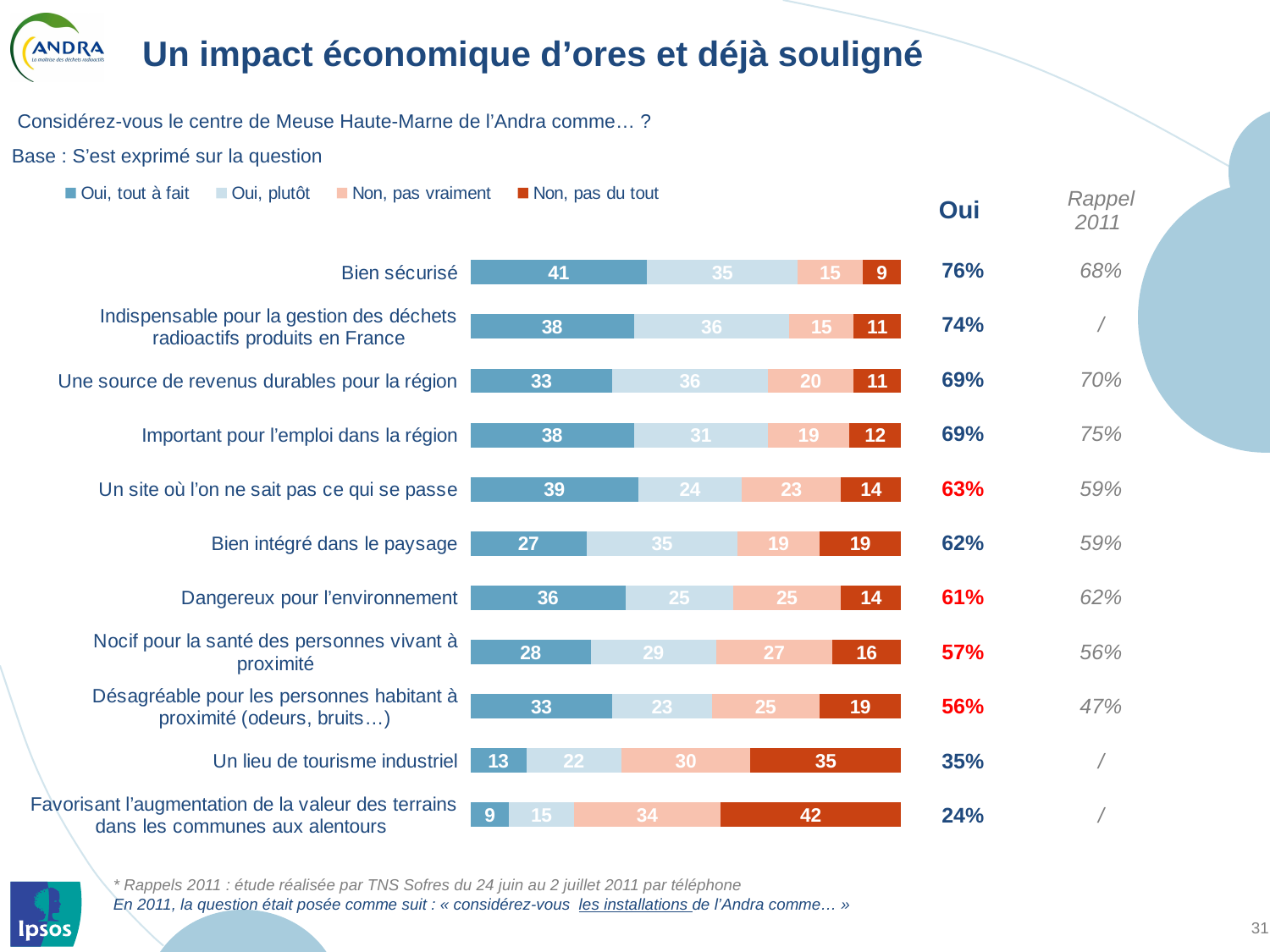
Which category has the highest "Oui, tout à fait" value? Bien sécurisé What kind of chart is shown on the slide? Stacked bar chart What is the total of the "Oui, tout à fait" and "Oui, plutôt" segments for "Important pour l'emploi dans la région"? 69 What is the difference between the "Oui, tout à fait" values for "Bien sécurisé" and "Bien intégré dans le paysage"? 14 How many series does the legend list? 4 Which is larger: the "Non, pas du tout" value for "Un lieu de tourisme industriel" or for "Dangereux pour l'environnement"? Un lieu de tourisme industriel What is the value of "Non, pas du tout" for "Favorisant l'augmentation de la valeur des terrains dans les communes aux alentours"? 42 Which category has the lowest "Oui, tout à fait" value? Favorisant l'augmentation de la valeur des terrains dans les communes aux alentours How many categories (statements) are plotted in the chart? 11 What is the value of "Non, pas vraiment" for "Un lieu de tourisme industriel"? 30 What is the value of "Oui, tout à fait" for "Bien sécurisé"? 41 What is the "Rappel 2011" value shown for "Désagréable pour les personnes habitant à proximité (odeurs, bruits…)"? 47%